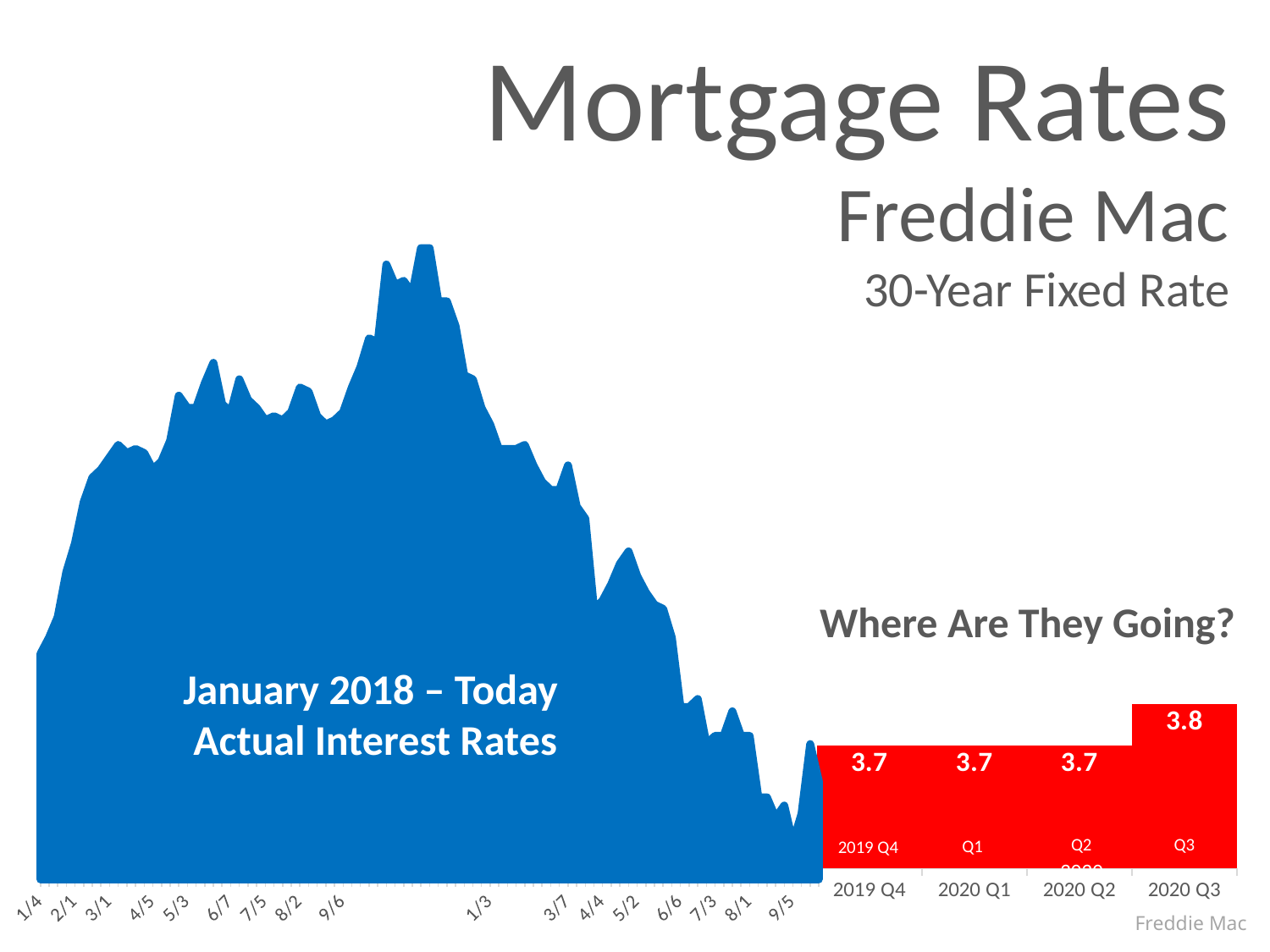
In the red forecast chart, what is the value for 2020 Q3? 3.8 In the red forecast chart, what is the difference between the 2020 Q3 value and the 2020 Q2 value? 0.1 In the red forecast chart, what is the value for 2020 Q2? 3.7 In the red forecast chart, do the values rise or fall from 2020 Q2 to 2020 Q3? Rise In the red forecast chart, which quarter has the highest value? 2020 Q3 What kind of chart is the blue chart showing actual interest rates? Area chart What kind of chart is the red forecast chart on the right? Bar chart In the red forecast chart, what is the value for 2019 Q4? 3.7 How many quarters are shown in the red forecast chart? 4 In the red forecast chart, which is larger, the value for 2020 Q3 or the value for 2019 Q4? 2020 Q3 What is the label printed on the blue area chart describing its data? January 2018 – Today Actual Interest Rates In the red forecast chart, what is the value for 2020 Q1? 3.7